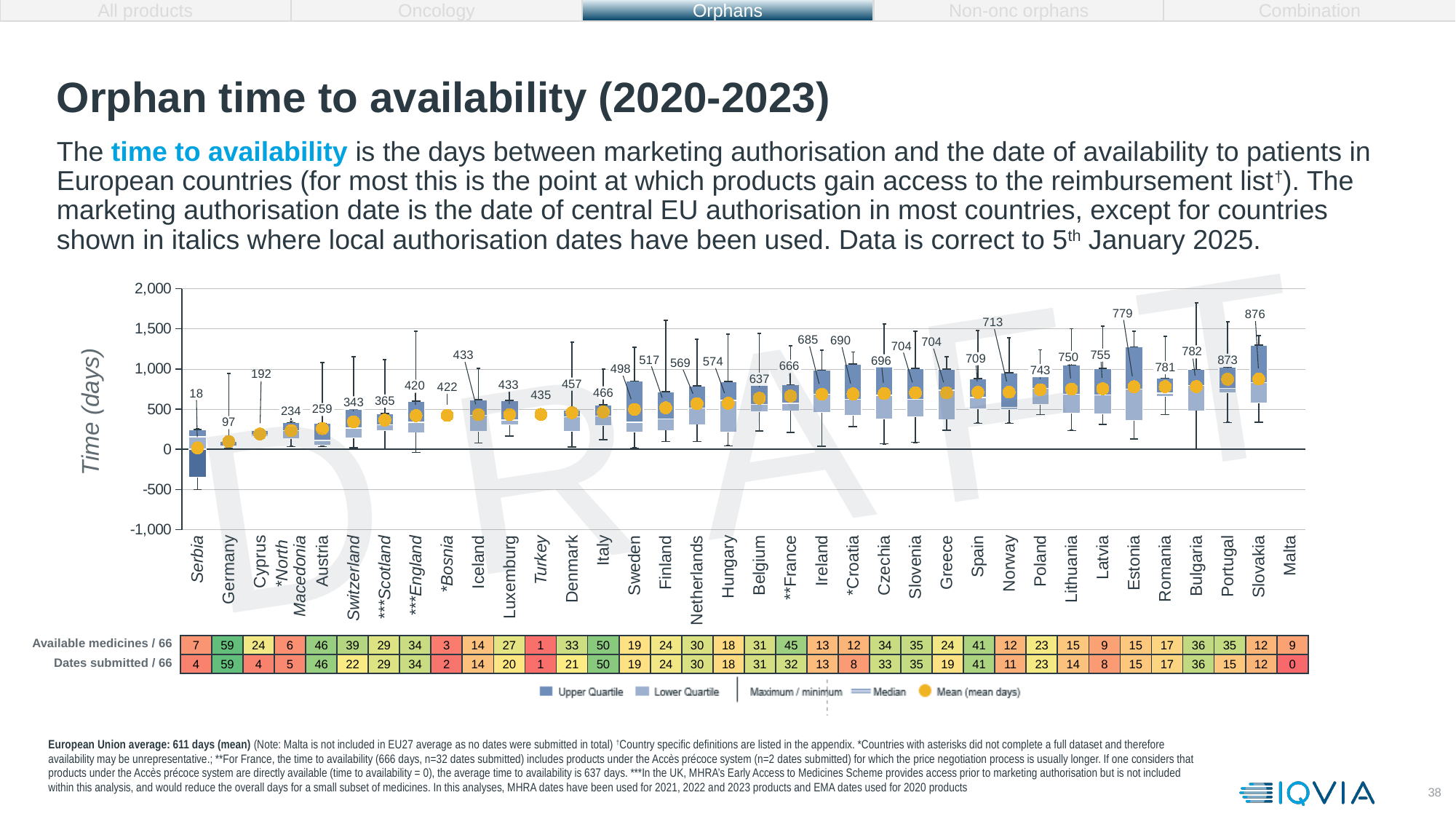
How many entries does the chart legend list? 5 What mean value is labelled for France? 666 Which country has the lowest labelled mean time to availability? Serbia What kind of chart is used to show the time to availability? Box plot (box-and-whisker chart) What is the difference between the labelled mean for Slovakia and the labelled mean for Serbia? 858 Which has a higher labelled mean time to availability, Belgium or Sweden? Belgium Is the labelled mean for Germany greater or less than 500 days? less Do the labelled mean values generally rise or fall moving from left to right along the x axis? Rise How many countries are listed along the x axis of the chart? 36 What is the mean time to availability (in days) shown for Germany? 97 What is the mean time to availability shown for Slovakia? 876 Which country has the highest labelled mean time to availability? Slovakia